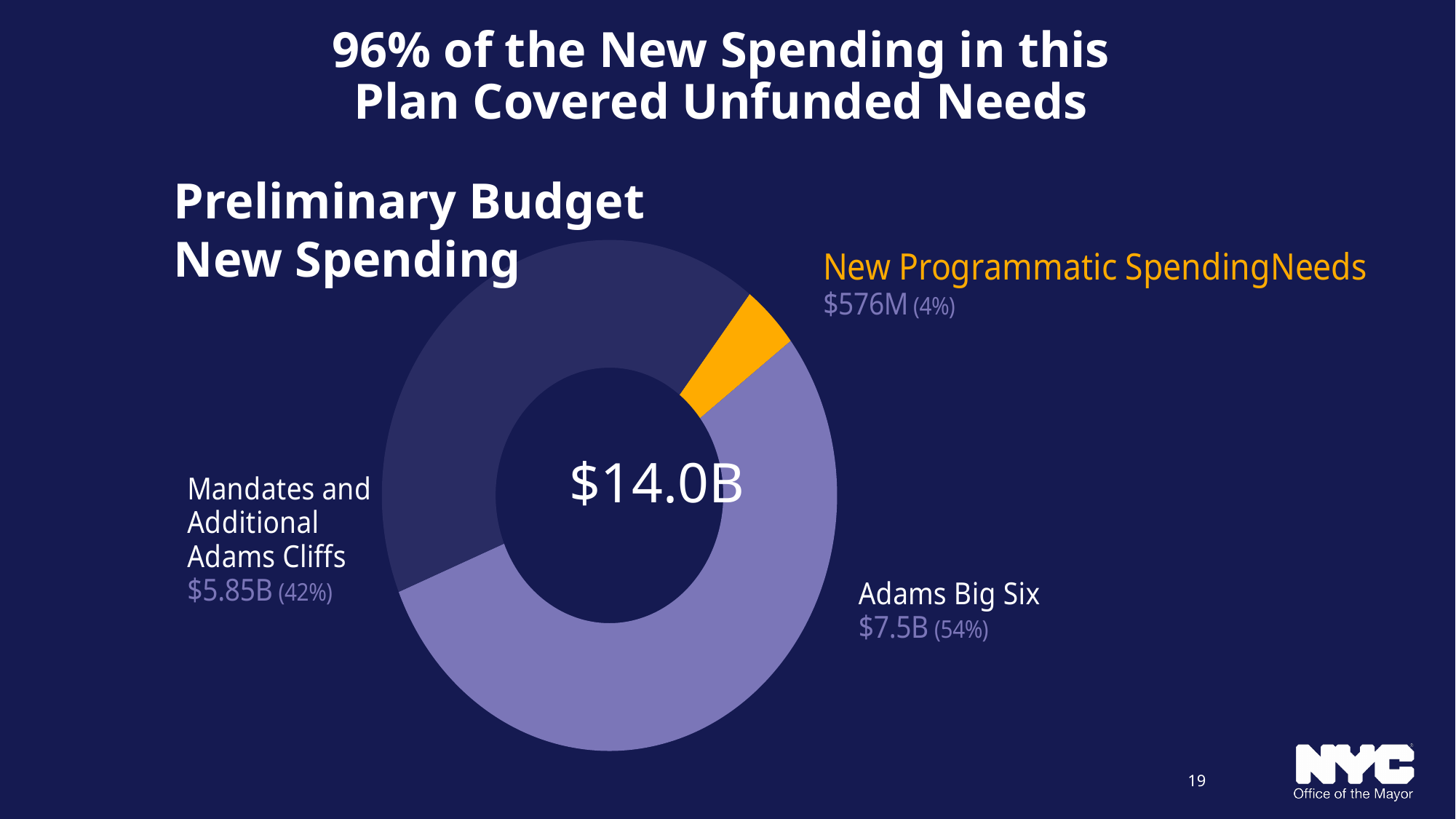
How many categories are shown in the chart? 3 Which category has the smallest slice? New Programmatic Spending Needs What is the value for Adams Big Six? $7.5B Which category has the largest slice? Adams Big Six What is the value for Mandates and Additional Adams Cliffs? $5.85B What total value is shown in the centre of the chart? $14.0B Which is larger, Adams Big Six or Mandates and Additional Adams Cliffs? Adams Big Six What share of the chart does Mandates and Additional Adams Cliffs represent? 42% What share of the chart does New Programmatic Spending Needs represent? 4% What share of the chart does Adams Big Six represent? 54% What is the value for New Programmatic Spending Needs? $576M What kind of chart is shown on the slide? Donut (pie) chart